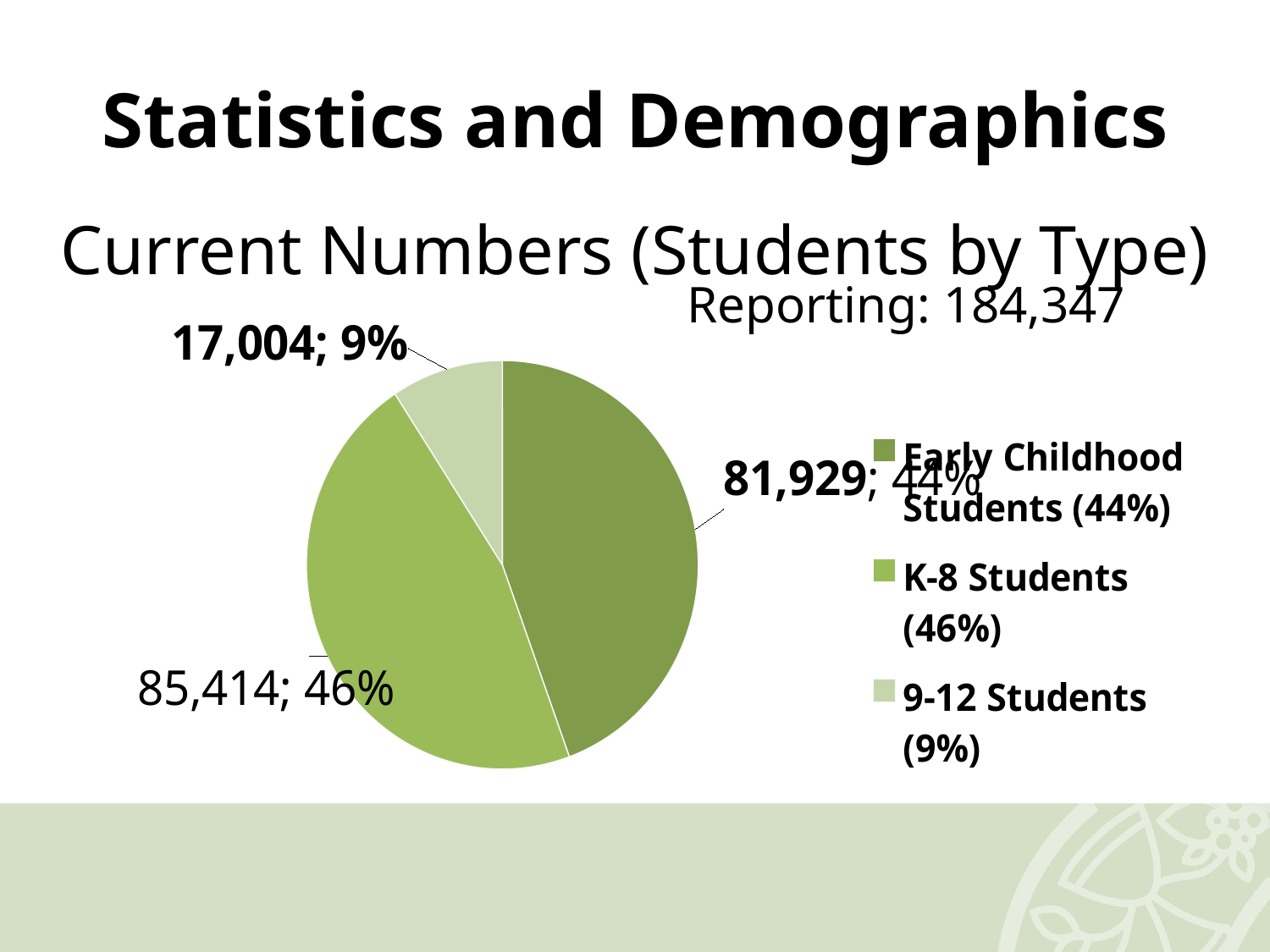
What is the difference between the number of K-8 Students and the number of Early Childhood Students? 3,485 What is the number of Early Childhood Students shown on the pie chart? 81,929 How many entries does the legend list? 3 What type of chart is shown on the slide? pie chart What is the number of 9-12 Students shown on the pie chart? 17,004 Which student type has the largest slice of the pie? K-8 Students What share of the pie do 9-12 Students represent? 9% How many slices does the pie chart have? 3 What total number of students reporting is stated above the pie chart? 184,347 Which student type has the smallest slice of the pie? 9-12 Students What share of the pie do K-8 Students represent? 46% What is the number of K-8 Students shown on the pie chart? 85,414